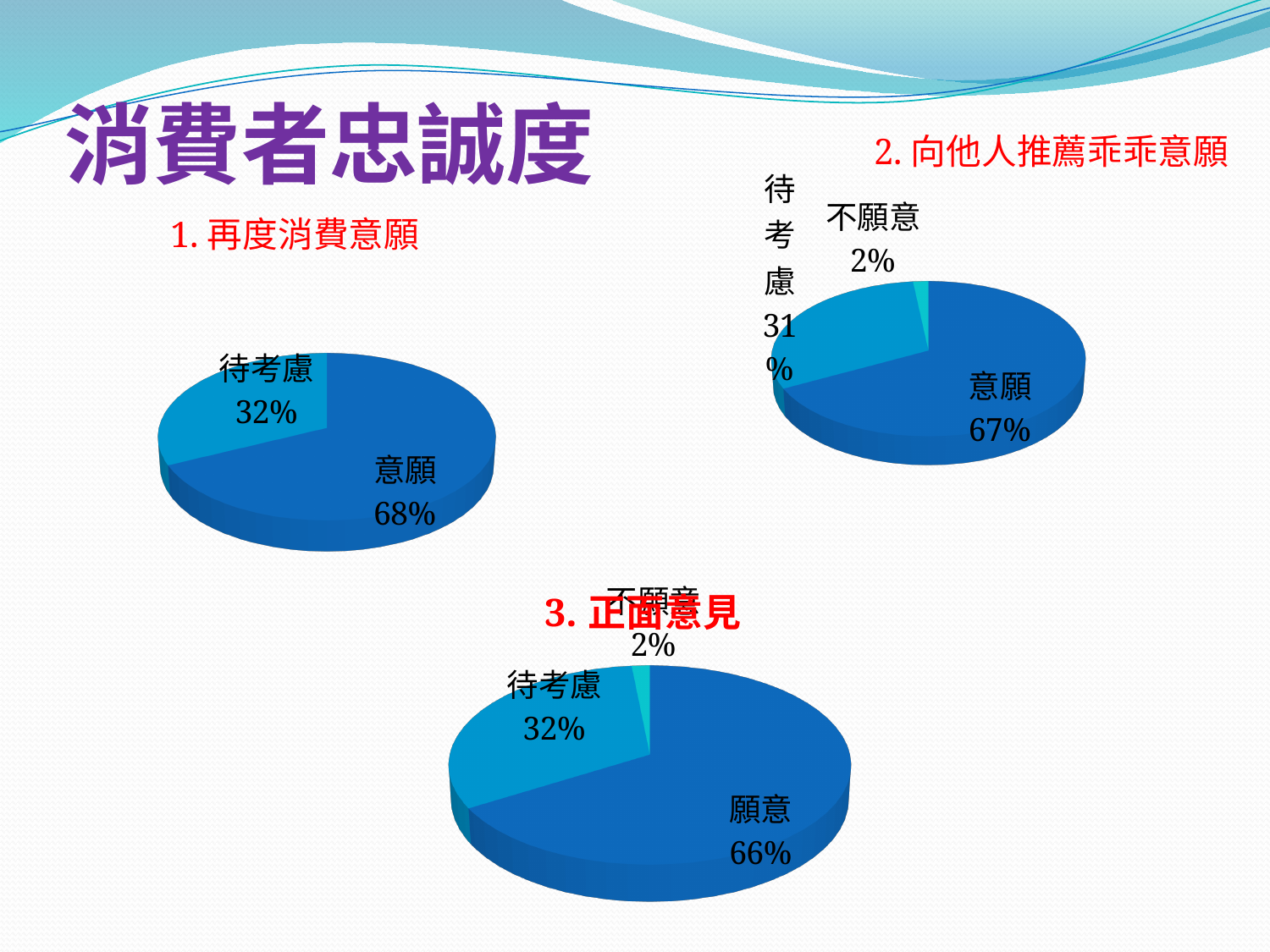
In the chart titled 1. 再度消費意願, how many slices does the pie have? 2 In the chart titled 1. 再度消費意願, what is the share for 意願? 68% In the chart titled 3. 正面意見, what is the share for 願意? 66% In the chart titled 3. 正面意見, which category has the largest slice? 願意 In the chart titled 2. 向他人推薦乖乖意願, what is the share for 不願意? 2% What type of chart is the chart titled 3. 正面意見? Pie chart In the chart titled 2. 向他人推薦乖乖意願, which category has the smallest slice? 不願意 In the chart titled 1. 再度消費意願, what is the share for 待考慮? 32% In the chart titled 2. 向他人推薦乖乖意願, what is the difference between the shares for 意願 and 待考慮? 36% In the chart titled 3. 正面意見, how many categories are shown? 3 In the chart titled 2. 向他人推薦乖乖意願, what is the share for 意願? 67% How many charts are shown on the slide? 3